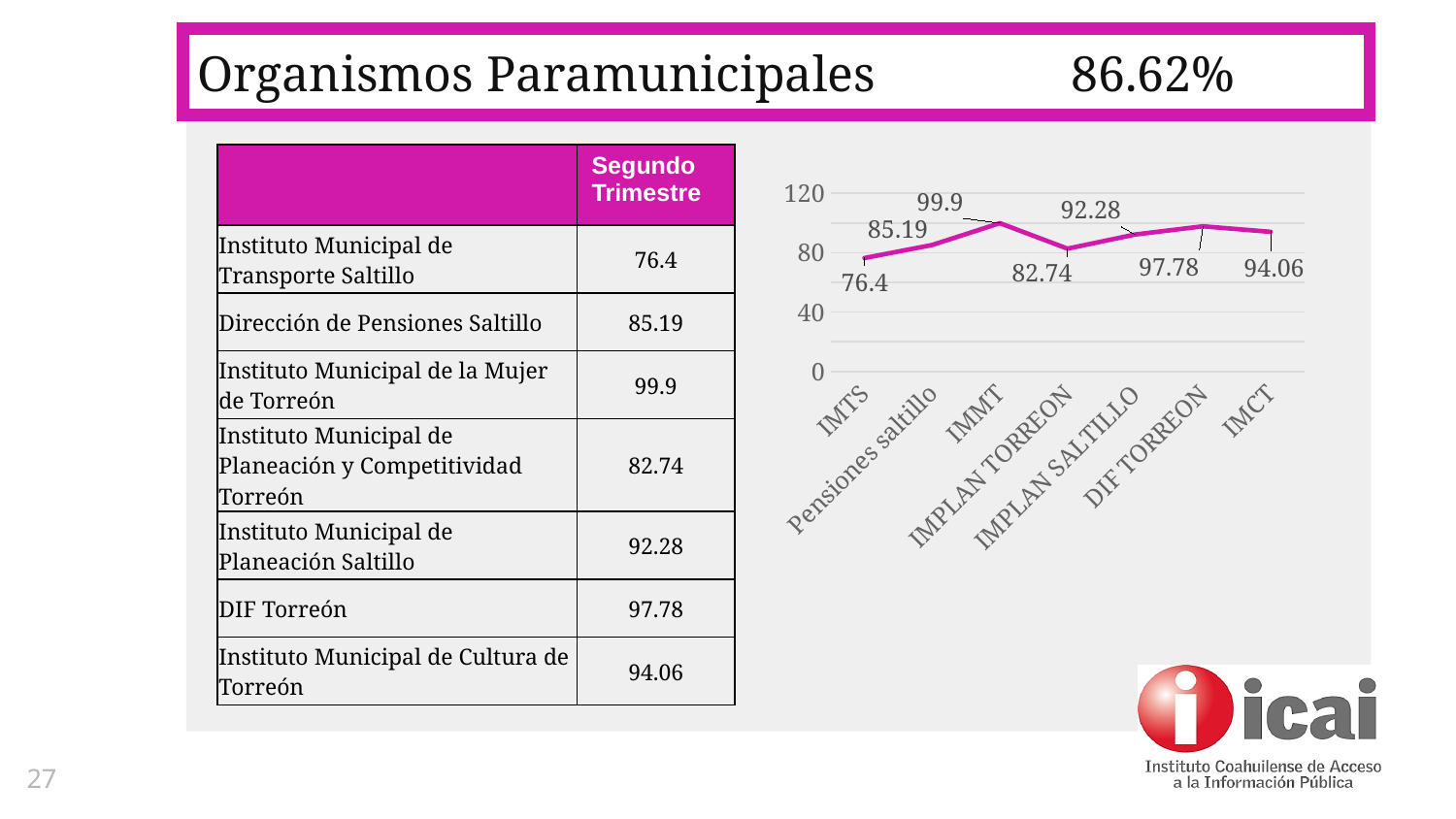
What is the value for DIF TORREON in the line chart? 97.78 What is the highest tick value shown on the vertical axis of the line chart? 120 What is the value for IMPLAN TORREON in the line chart? 82.74 What kind of chart is shown on the slide? line chart Is the value for Pensiones saltillo greater or less than 80? greater What is the difference between the values for IMMT and IMTS? 23.5 How many categories are plotted along the x axis of the line chart? 7 Which category has the lowest value in the line chart? IMTS What is the value for IMTS in the line chart? 76.4 What is the value for IMCT in the line chart? 94.06 Which category has the highest value in the line chart? IMMT Which is larger, the value for IMPLAN SALTILLO or the value for IMPLAN TORREON? IMPLAN SALTILLO